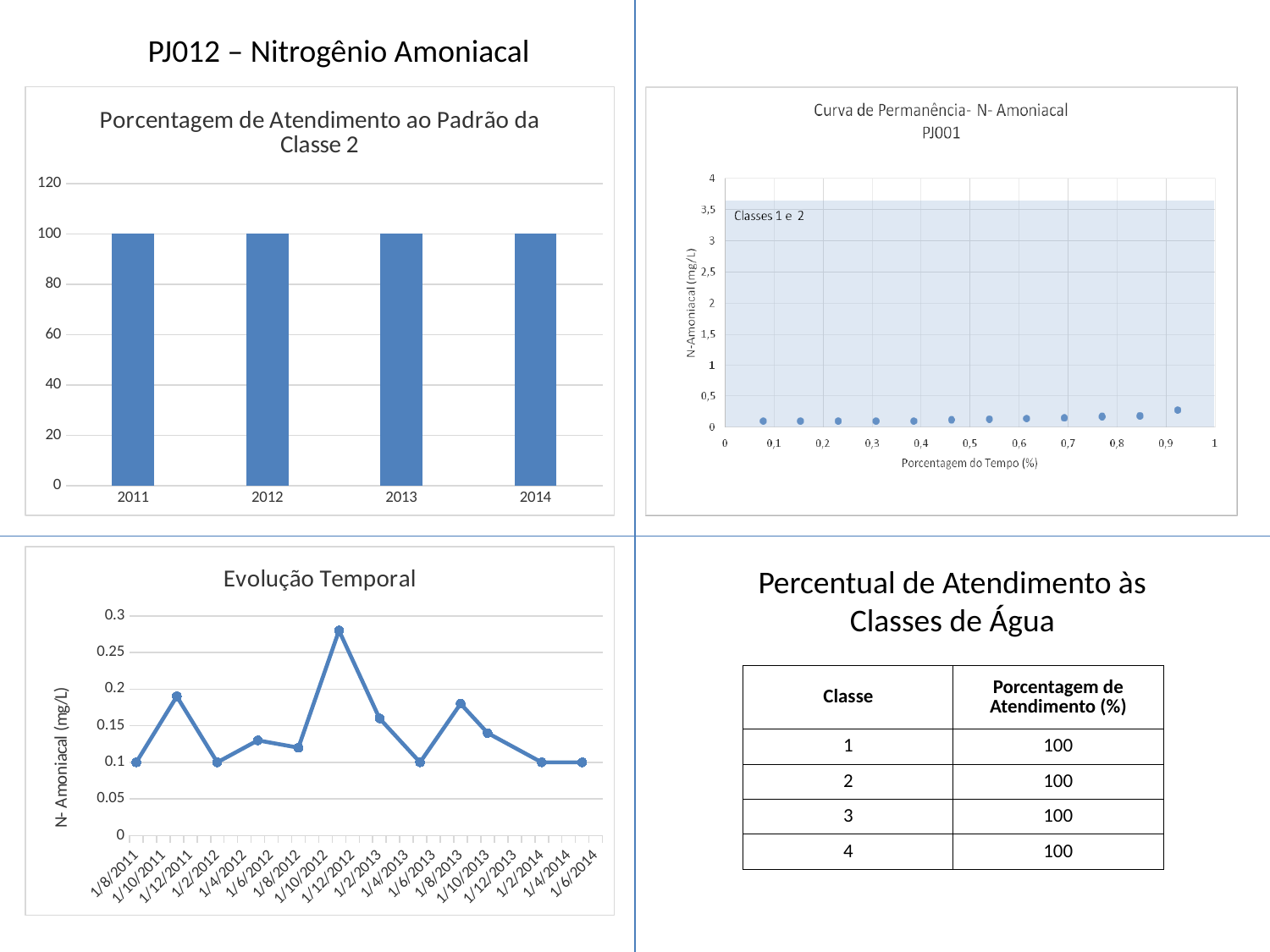
How many years are shown in the chart 'Porcentagem de Atendimento ao Padrão da Classe 2'? 4 In the chart 'Porcentagem de Atendimento ao Padrão da Classe 2', what is the value for 2013? 100 In the chart 'Porcentagem de Atendimento ao Padrão da Classe 2', is the value for 2011 larger than, smaller than, or equal to the value for 2014? equal What kind of chart is 'Evolução Temporal'? line chart What is the x-axis label of the chart 'Curva de Permanência- N- Amoniacal PJ001'? Porcentagem do Tempo (%) What kind of chart is 'Porcentagem de Atendimento ao Padrão da Classe 2'? bar chart In the chart 'Evolução Temporal', is the highest plotted value greater or less than 0.25? greater In the chart 'Curva de Permanência- N- Amoniacal PJ001', are all plotted values greater or less than 0.5? less In the chart 'Curva de Permanência- N- Amoniacal PJ001', do the plotted values rise or fall as the x axis increases? rise In the chart 'Porcentagem de Atendimento ao Padrão da Classe 2', what is the difference between the values for 2012 and 2013? 0 What is the y-axis label of the chart 'Evolução Temporal'? N- Amoniacal (mg/L) In the chart 'Evolução Temporal', what is the lowest value plotted on the y axis? 0.1